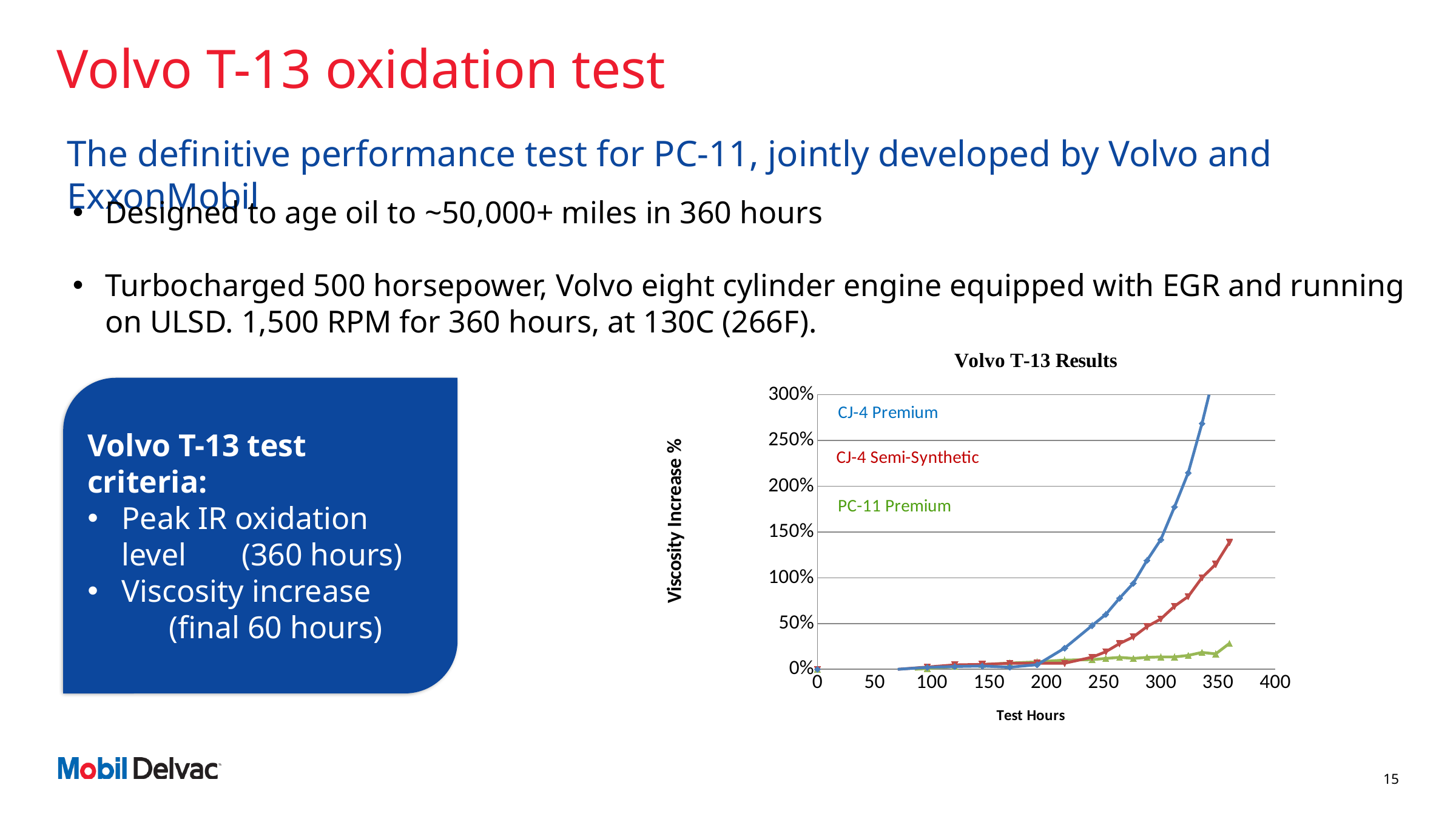
Which series has the highest viscosity increase at 350 test hours? CJ-4 Premium Is the viscosity increase for CJ-4 Premium at 350 test hours greater or less than 250%? greater What is the title of the chart on the slide? Volvo T-13 Results Does the viscosity increase for CJ-4 Premium rise or fall as test hours increase beyond 200? rise Is the viscosity increase for CJ-4 Premium at 250 test hours greater or less than 100%? less At 300 test hours, which series has the larger viscosity increase, CJ-4 Premium or CJ-4 Semi-Synthetic? CJ-4 Premium Which series has the lowest viscosity increase at 350 test hours? PC-11 Premium Is the viscosity increase for PC-11 Premium at 350 test hours greater or less than 50%? less What is the label of the y axis in the Volvo T-13 Results chart? Viscosity Increase % How many series are plotted in the Volvo T-13 Results chart? 3 What kind of chart is the Volvo T-13 Results chart? line chart At 300 test hours, which series has the larger viscosity increase, CJ-4 Semi-Synthetic or PC-11 Premium? CJ-4 Semi-Synthetic